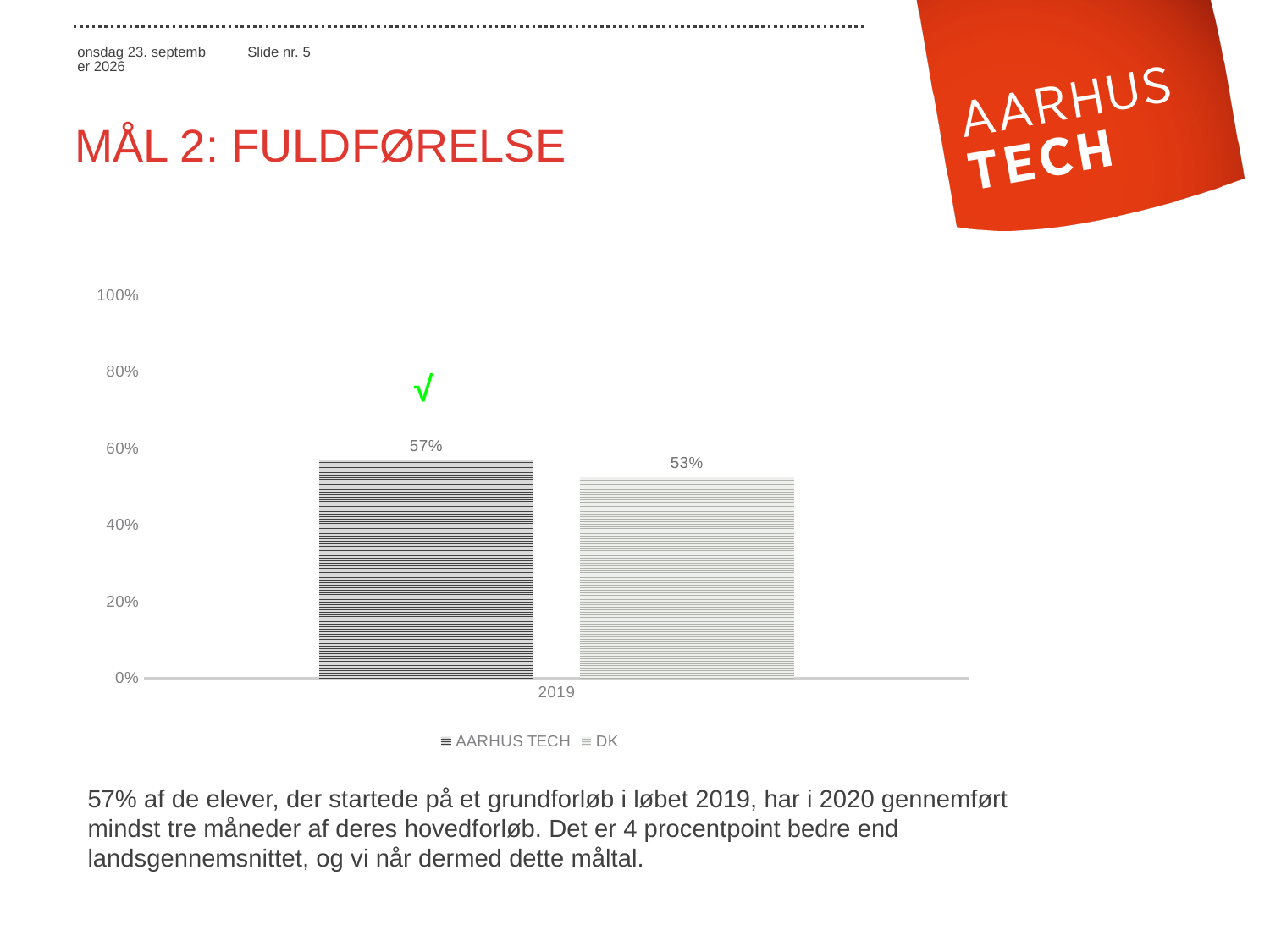
How many categories are shown on the x axis? 1 What is the value for DK in 2019? 53% Is the value for AARHUS TECH in 2019 greater or less than 40%? greater What is the difference between the AARHUS TECH value and the DK value in 2019? 4% What is the value for AARHUS TECH in 2019? 57% What kind of chart is shown on the slide? bar chart Is the value for DK in 2019 greater or less than 60%? less Which series has the higher value in 2019, AARHUS TECH or DK? AARHUS TECH What is the category label on the x axis? 2019 Which series has the lowest value in 2019? DK How many series does the legend list? 2 What is the highest value shown on the y axis? 100%